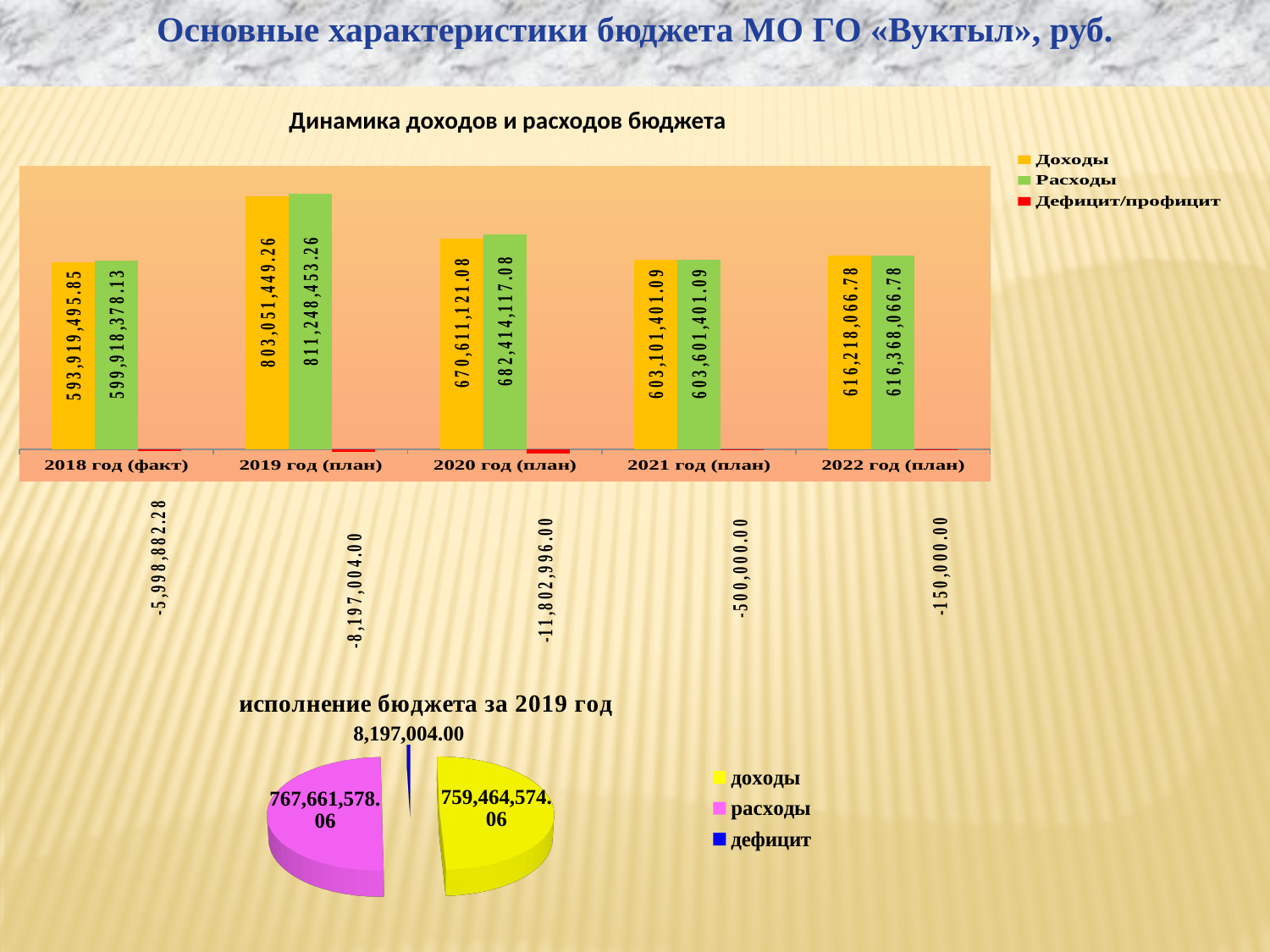
In the chart 'Динамика доходов и расходов бюджета', which year has the lowest Расходы? 2018 год (факт) In the chart 'Динамика доходов и расходов бюджета', what is the value of Доходы for 2018 год (факт)? 593,919,495.85 In the chart 'Динамика доходов и расходов бюджета', which year has the highest Доходы? 2019 год (план) In the pie chart 'исполнение бюджета за 2019 год', which slice is the smallest? дефицит In the chart 'Динамика доходов и расходов бюджета', how many series does the legend list? 3 In the chart 'Динамика доходов и расходов бюджета', what is the difference between Расходы and Доходы for 2019 год (план)? 8,197,004.00 In the chart 'Динамика доходов и расходов бюджета', what is the value of Дефицит/профицит for 2021 год (план)? -500,000.00 In the pie chart 'исполнение бюджета за 2019 год', what is the value of расходы? 767,661,578.06 What kind of chart is 'Динамика доходов и расходов бюджета'? Bar chart In the chart 'Динамика доходов и расходов бюджета', what is the value of Расходы for 2020 год (план)? 682,414,117.08 In the chart 'Динамика доходов и расходов бюджета', is Доходы larger for 2020 год (план) or 2022 год (план)? 2020 год (план) In the chart 'Динамика доходов и расходов бюджета', how many years are shown on the x axis? 5